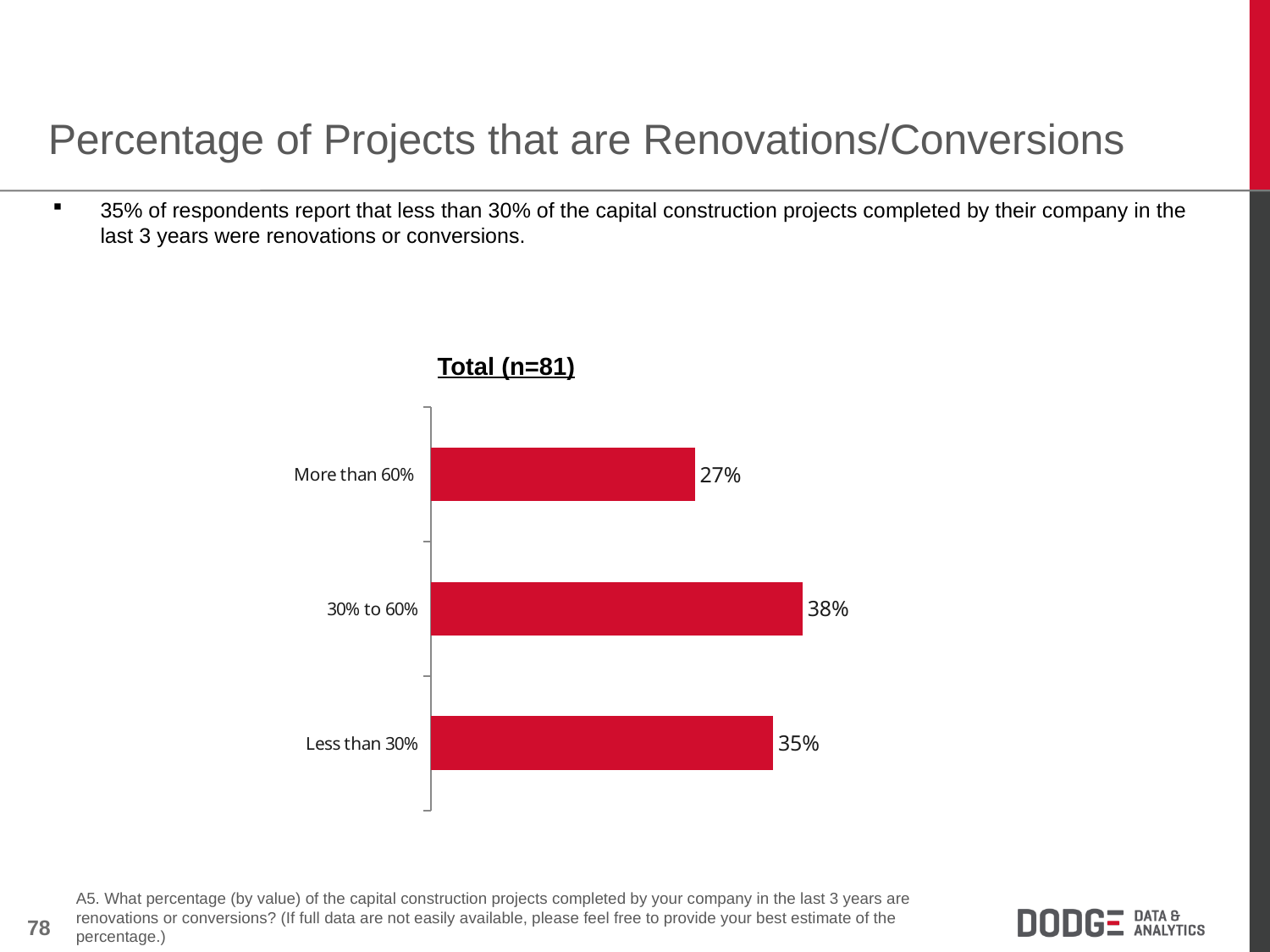
What is the value for the '30% to 60%' category? 38% What is the difference between the values for '30% to 60%' and 'More than 60%'? 11% What is the title of the chart? Total (n=81) How many categories are shown in the chart? 3 What is the value for the 'More than 60%' category? 27% What kind of chart is shown on the slide? Bar chart What colour are the bars in the chart? Red Which category has the lowest value? More than 60% What is the difference between the values for 'Less than 30%' and 'More than 60%'? 8% Which is larger, the value for 'Less than 30%' or the value for '30% to 60%'? 30% to 60% Which category has the highest value? 30% to 60% What percentage of respondents report that less than 30% of their projects were renovations or conversions? 35%